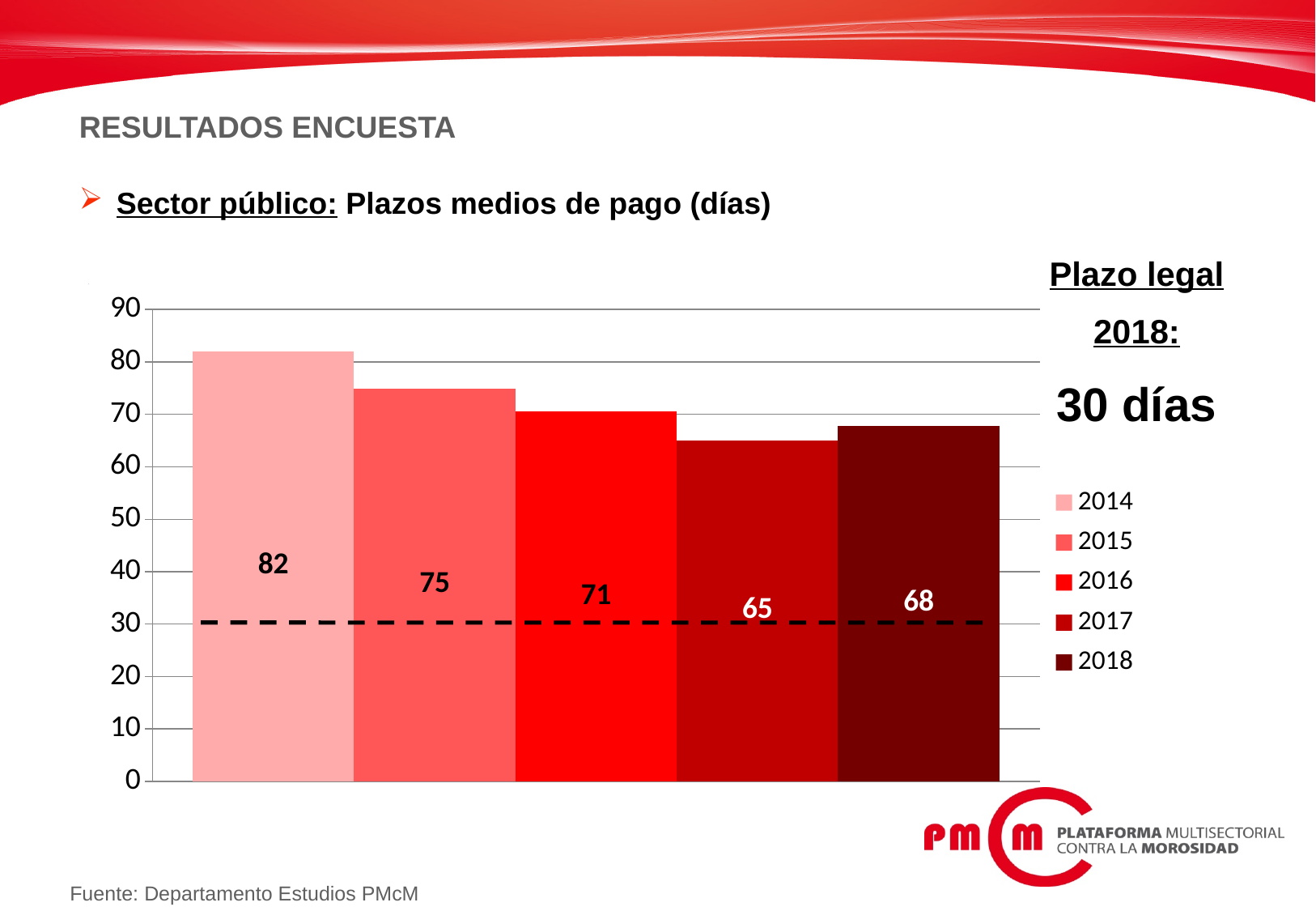
What is the value shown for 2017? 65 What is the value shown for 2018? 68 How many years are plotted in the chart? 5 What is the average payment period for 2014? 82 What is the difference between the values for 2014 and 2018? 14 What legal payment period (plazo legal) for 2018 is indicated next to the chart? 30 días What kind of chart is shown on the slide? bar chart Which year has the lowest average payment period? 2017 Is the value for 2017 greater or less than 30? greater What is the difference between the values for 2015 and 2016? 4 Which is larger, the value for 2016 or the value for 2018? 2016 Which year has the highest average payment period? 2014